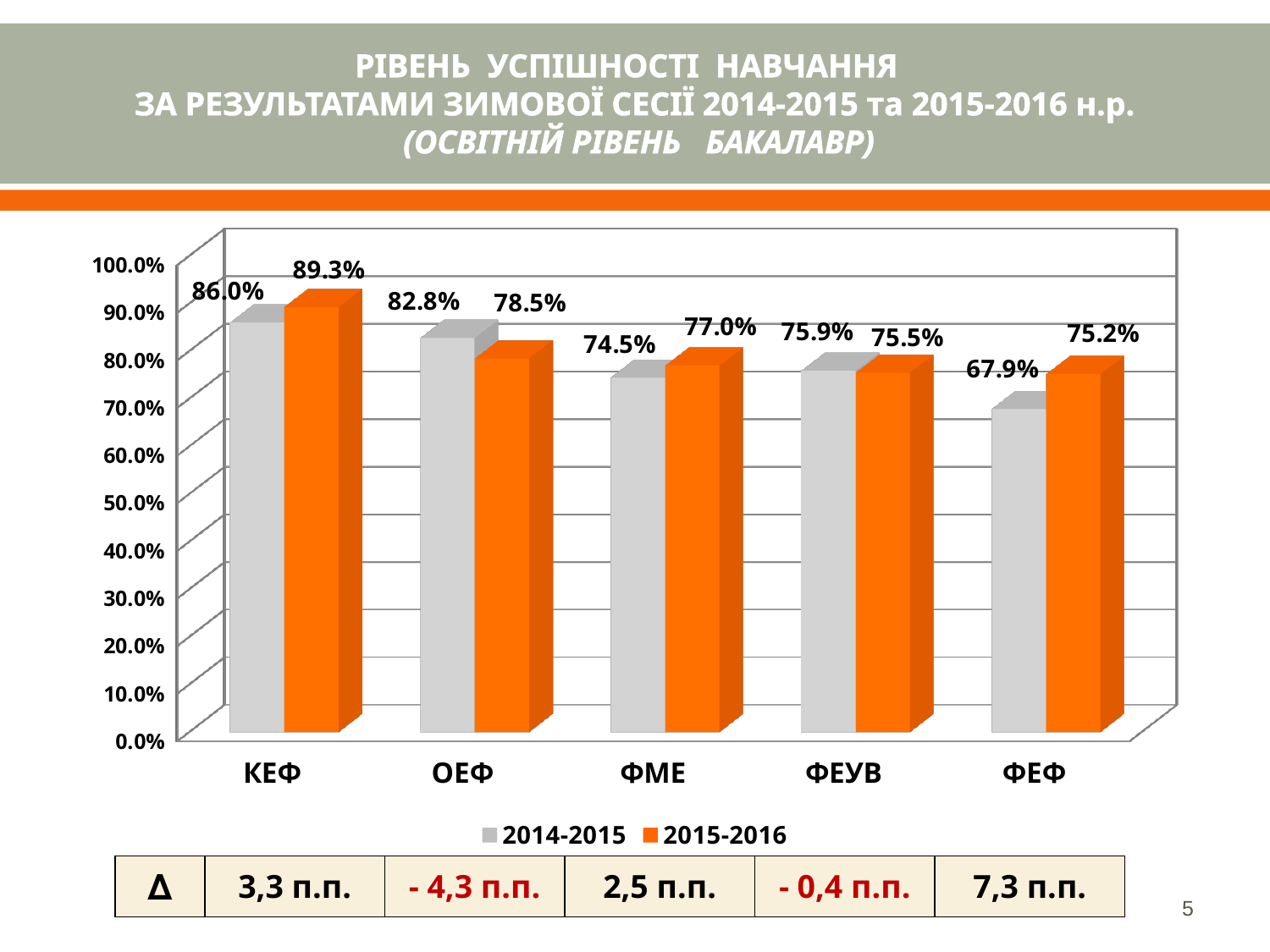
Is the 2014-2015 value for ФМЕ greater or less than 80.0%? less Which category has the lowest value in the 2015-2016 series? ФЕФ Which category has the highest value in the 2014-2015 series? КЕФ What is the value for ФЕФ in the 2014-2015 series? 67.9% How many categories are shown on the x axis? 5 Which colour represents the 2015-2016 series in the legend? orange What is the difference between the 2015-2016 and 2014-2015 values for ФЕФ? 7.3 percentage points How many series does the legend list? 2 What is the value for ОЕФ in the 2015-2016 series? 78.5% What is the value for КЕФ in the 2015-2016 series? 89.3% For ОЕФ, which series has the larger value, 2014-2015 or 2015-2016? 2014-2015 What kind of chart is shown on the slide? bar chart